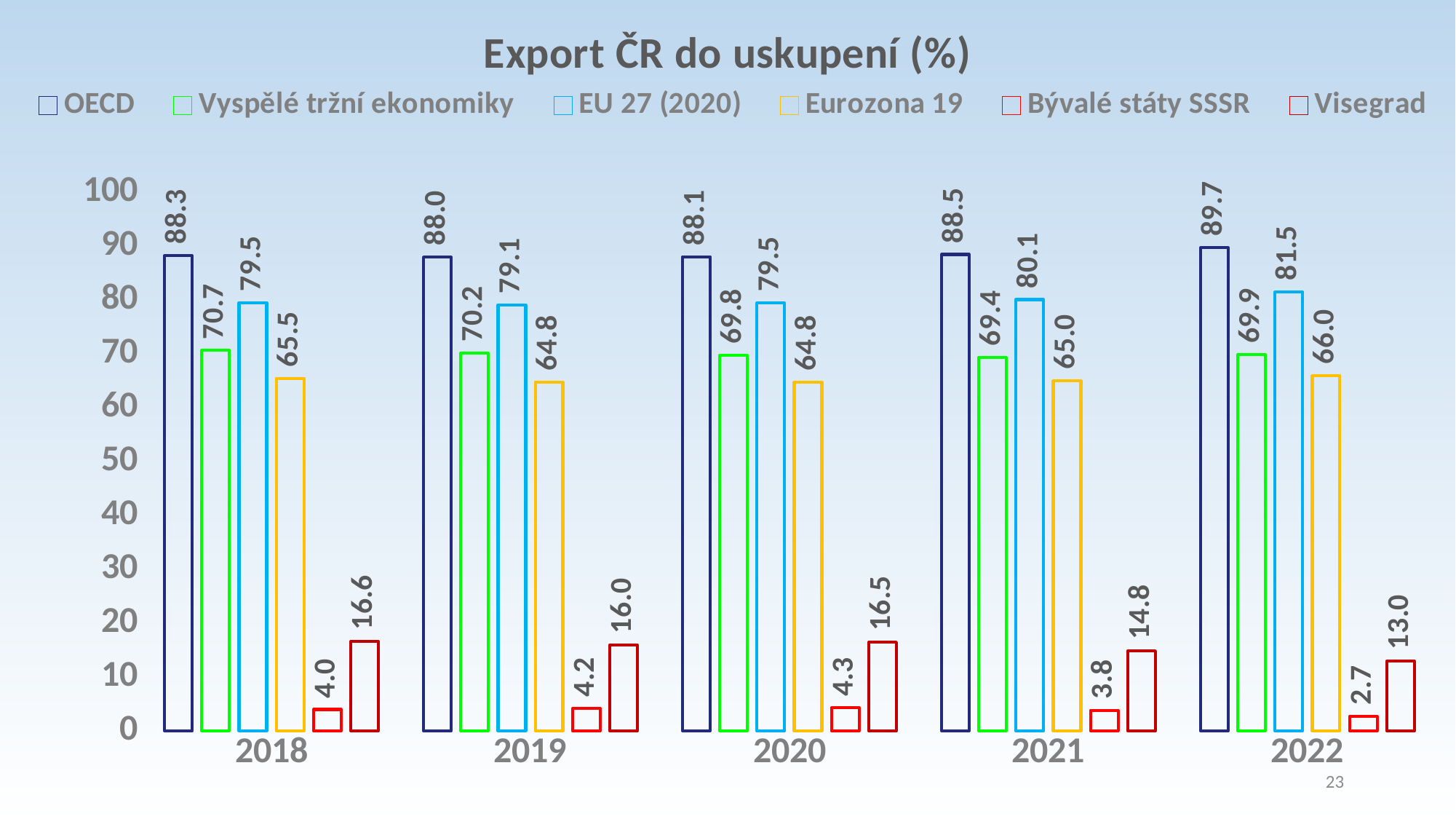
What is the value for Visegrad in 2018? 16.6 In which year is the OECD value highest? 2022 What is the difference between the Eurozona 19 values in 2022 and 2018? 0.5 How many years are shown on the x axis? 5 What is the value for Bývalé státy SSSR in 2022? 2.7 What kind of chart is this? bar chart How many series does the legend list? 6 In which year is the Visegrad value lowest? 2022 What is the value for OECD in 2022? 89.7 What is the title of the chart? Export ČR do uskupení (%) What is the value for EU 27 (2020) in 2021? 80.1 Which is larger: Vyspělé tržní ekonomiky in 2018 or in 2021? 2018